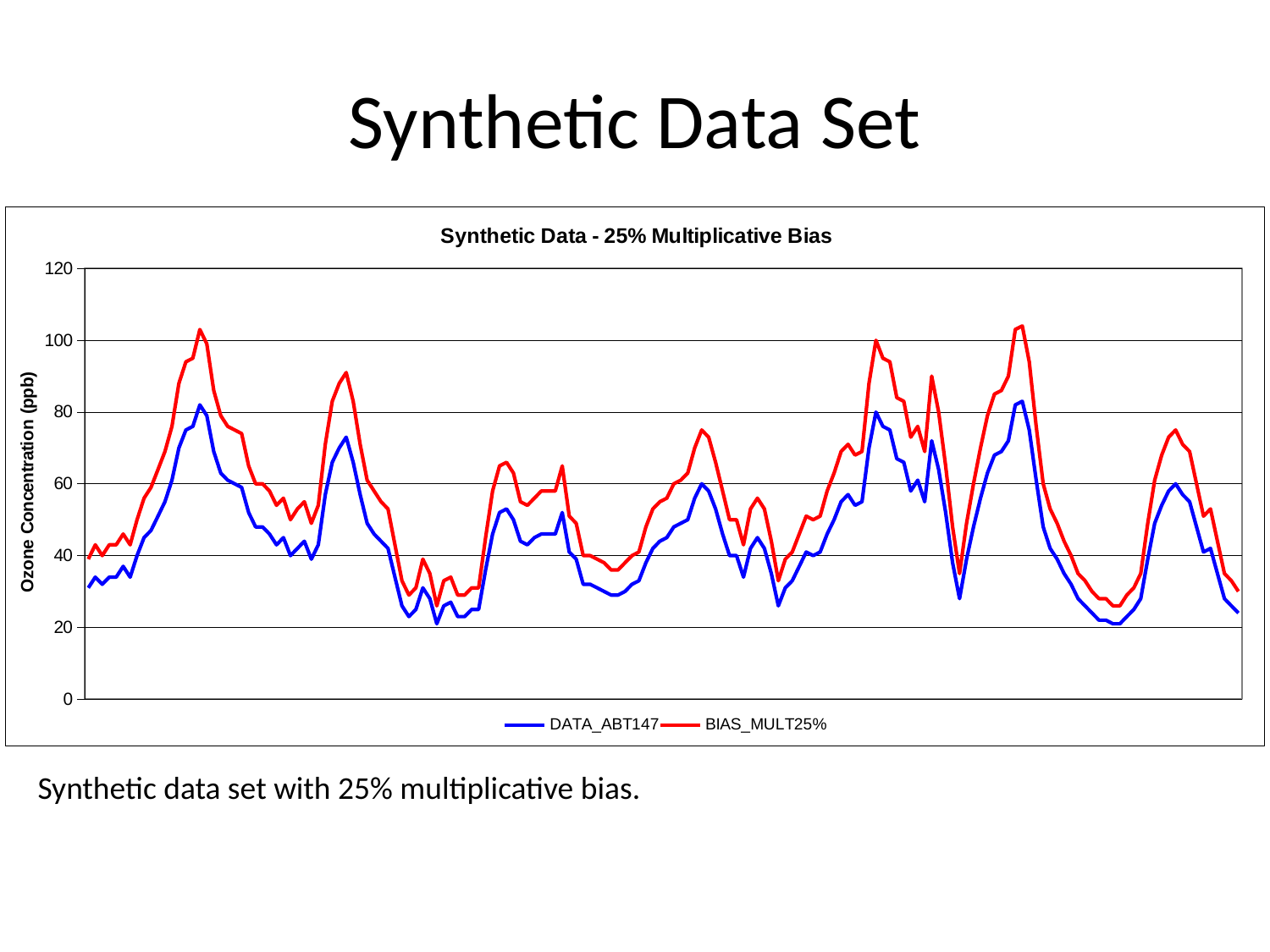
How many series does the legend list? 2 Which series has the higher values across the chart, DATA_ABT147 or BIAS_MULT25%? BIAS_MULT25% Is the highest value of the BIAS_MULT25% series greater or less than 80? greater Which series is plotted in red? BIAS_MULT25% Which series is plotted in blue? DATA_ABT147 What is the label of the vertical axis? Ozone Concentration (ppb) Is the highest value of the DATA_ABT147 series greater or less than 100? less Is the lowest value of the DATA_ABT147 series greater or less than 40? less What kind of chart is shown on the slide? Line chart